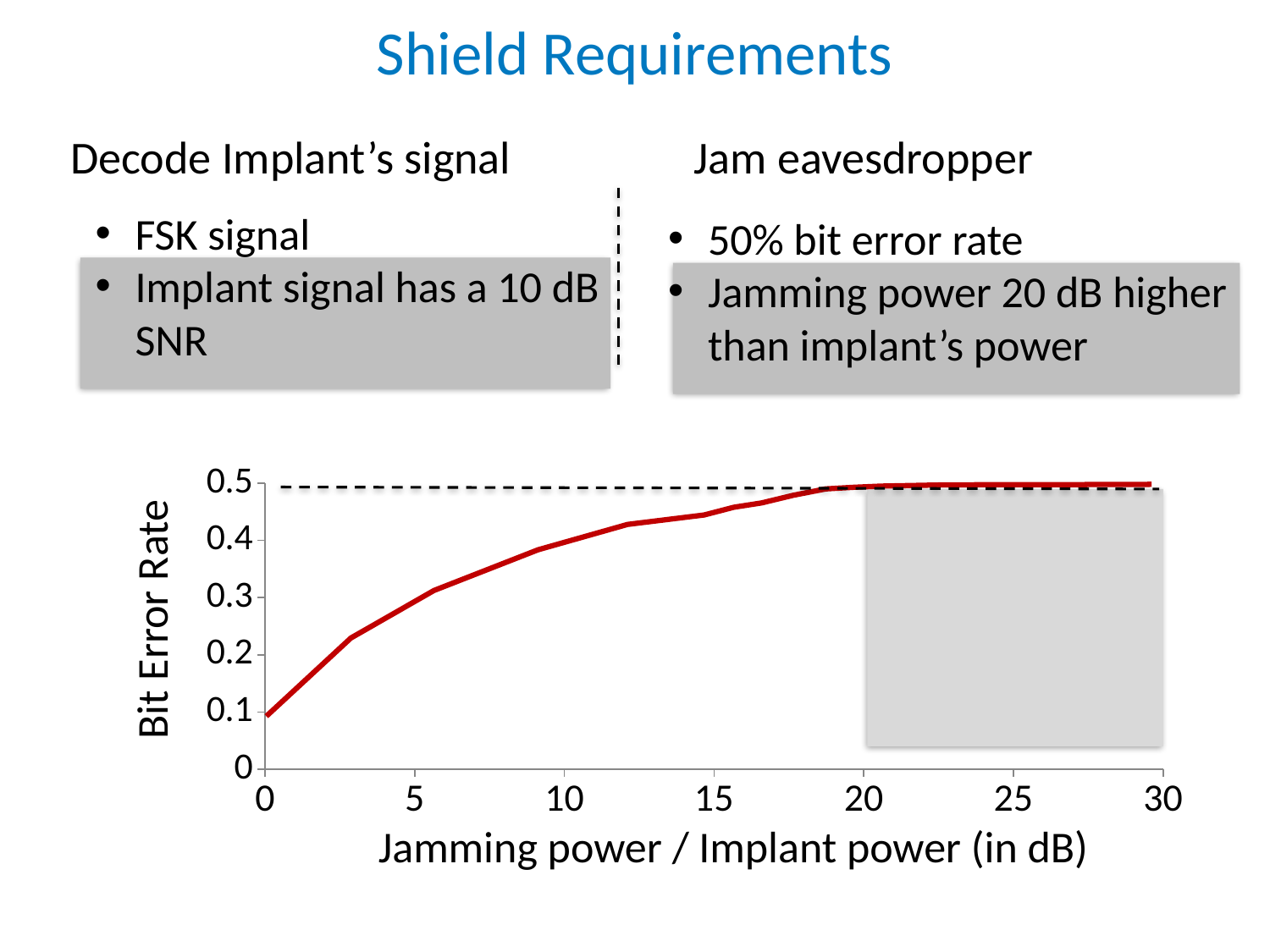
Which is larger, the bit error rate at 5 dB or at 15 dB? 15 dB Is the bit error rate at 10 dB greater or less than 0.3? greater What is the label of the y axis of the chart? Bit Error Rate Is the bit error rate at 15 dB greater or less than 0.4? greater What is the label of the x axis of the chart? Jamming power / Implant power (in dB) Does the bit error rate rise or fall as the jamming power / implant power increases along the x axis? rise What is the highest value shown on the y axis of the chart? 0.5 Is the bit error rate at 0 dB greater or less than 0.2? less What kind of chart is shown on the slide? line chart At which jamming power / implant power value is the bit error rate lowest? 0